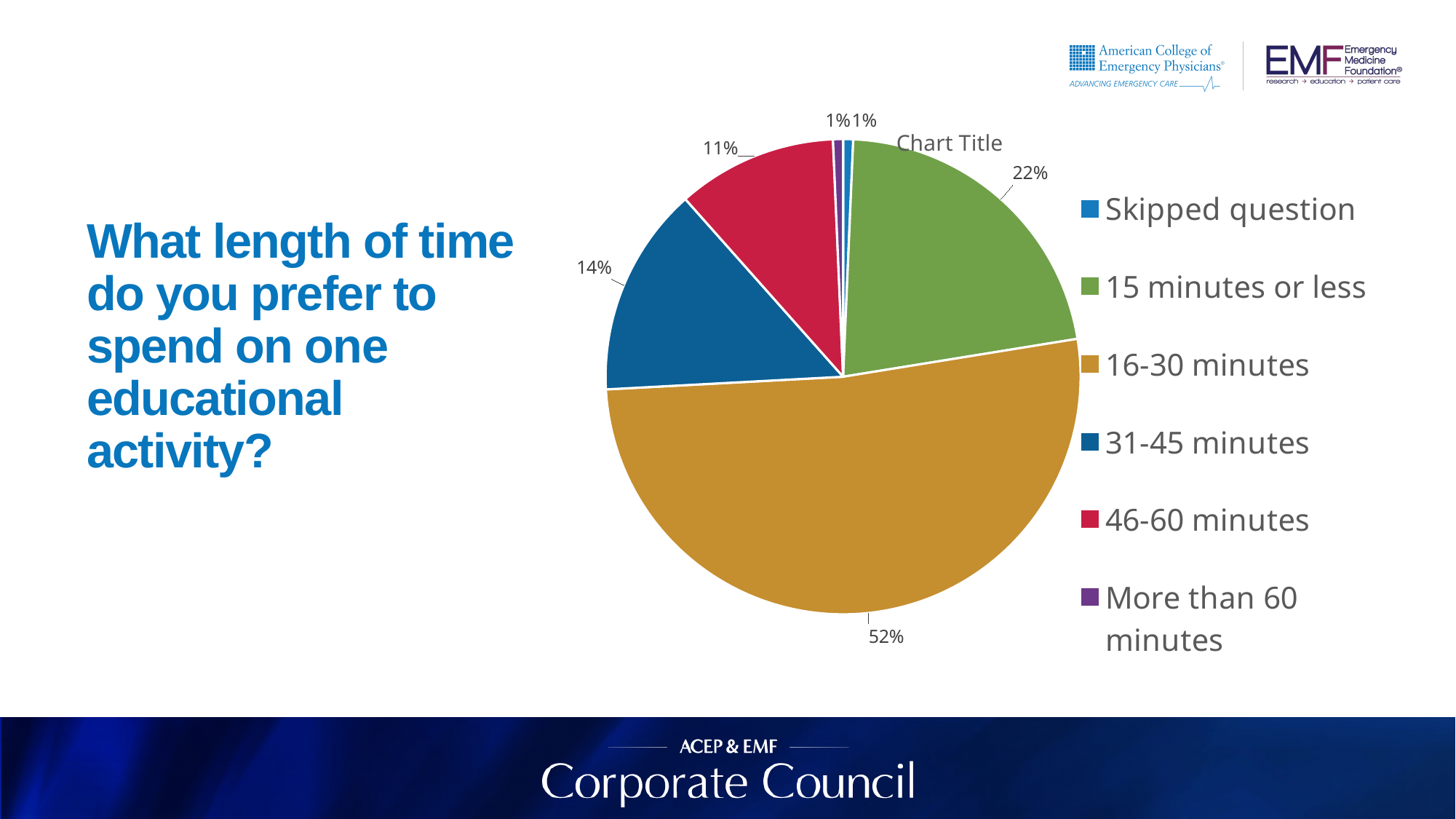
What percentage of respondents prefer 15 minutes or less? 22% What type of chart is shown on the slide? Pie chart What percentage of respondents prefer more than 60 minutes? 1% What percentage of respondents prefer 46-60 minutes? 11% What percentage of respondents prefer 31-45 minutes? 14% Which is larger, the share for 31-45 minutes or the share for 46-60 minutes? 31-45 minutes What is the combined percentage for 31-45 minutes and 46-60 minutes? 25% How many categories does the legend list? 6 What is the difference in percentage points between 16-30 minutes and 15 minutes or less? 30 What percentage of respondents prefer 16-30 minutes? 52% Which category has the largest share of the pie? 16-30 minutes What colour represents the 16-30 minutes category? Gold